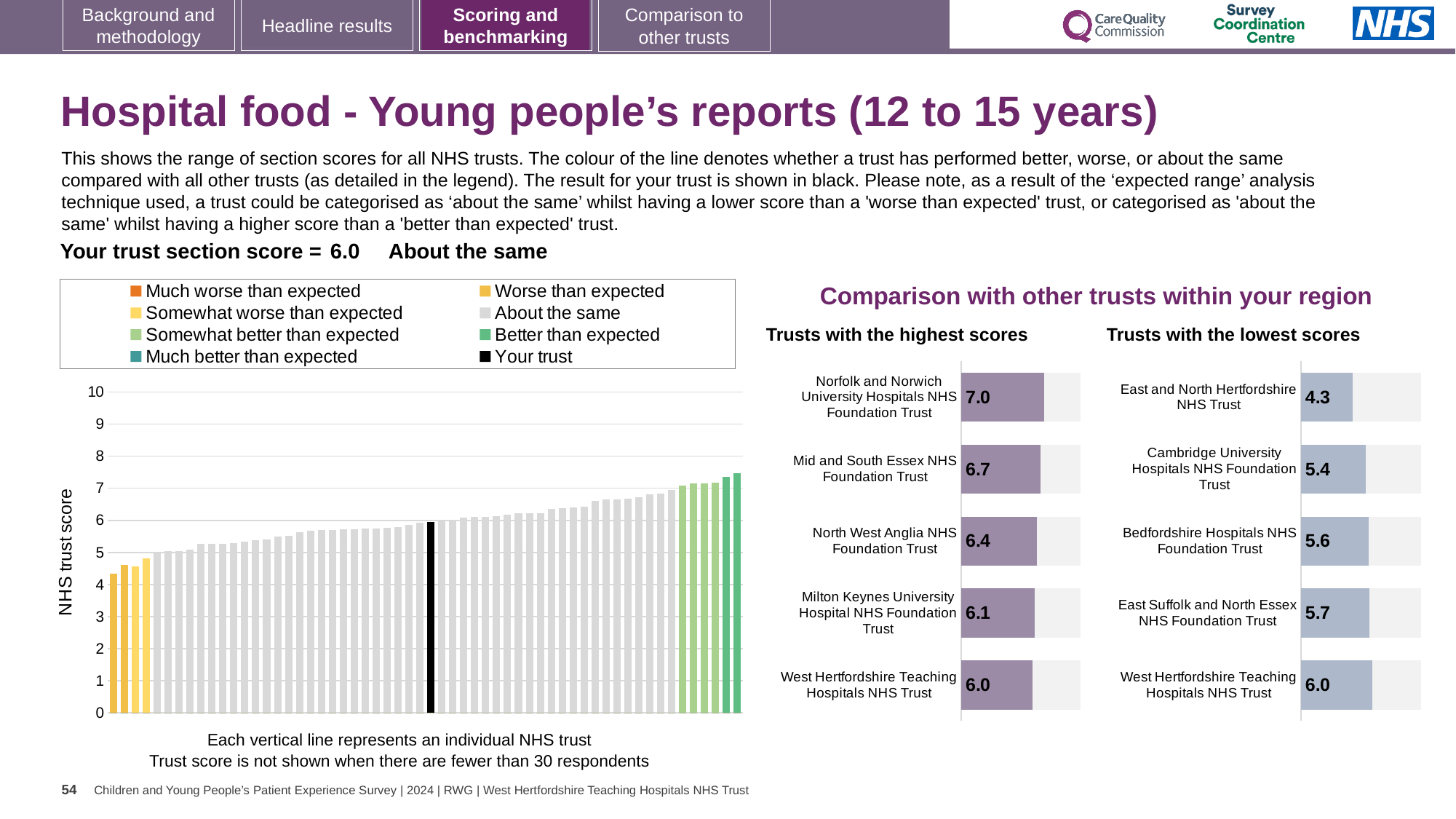
In the main 'NHS trust score' chart on the left, is the value of the shortest bar greater or less than 5? less In the 'Trusts with the lowest scores' chart, which has the higher score: Cambridge University Hospitals NHS Foundation Trust or Bedfordshire Hospitals NHS Foundation Trust? Bedfordshire Hospitals NHS Foundation Trust In the 'Trusts with the lowest scores' chart, what is the score for East and North Hertfordshire NHS Trust? 4.3 In the 'Trusts with the highest scores' chart, what is the score for Norfolk and Norwich University Hospitals NHS Foundation Trust? 7.0 In the 'Trusts with the highest scores' chart, what is the difference between the scores of Norfolk and Norwich University Hospitals NHS Foundation Trust and West Hertfordshire Teaching Hospitals NHS Trust? 1.0 In the 'Trusts with the lowest scores' chart, what is the difference between the scores of West Hertfordshire Teaching Hospitals NHS Trust and East and North Hertfordshire NHS Trust? 1.7 In the 'Trusts with the highest scores' chart, what is the score for North West Anglia NHS Foundation Trust? 6.4 How many trusts are shown in the 'Trusts with the highest scores' chart? 5 In the 'Trusts with the lowest scores' chart, which trust has the lowest score? East and North Hertfordshire NHS Trust How many entries does the legend of the main 'NHS trust score' chart on the left list? 8 In the main 'NHS trust score' chart on the left, is the value of the tallest bar greater or less than 7? greater In the 'Trusts with the highest scores' chart, which trust has the highest score? Norfolk and Norwich University Hospitals NHS Foundation Trust